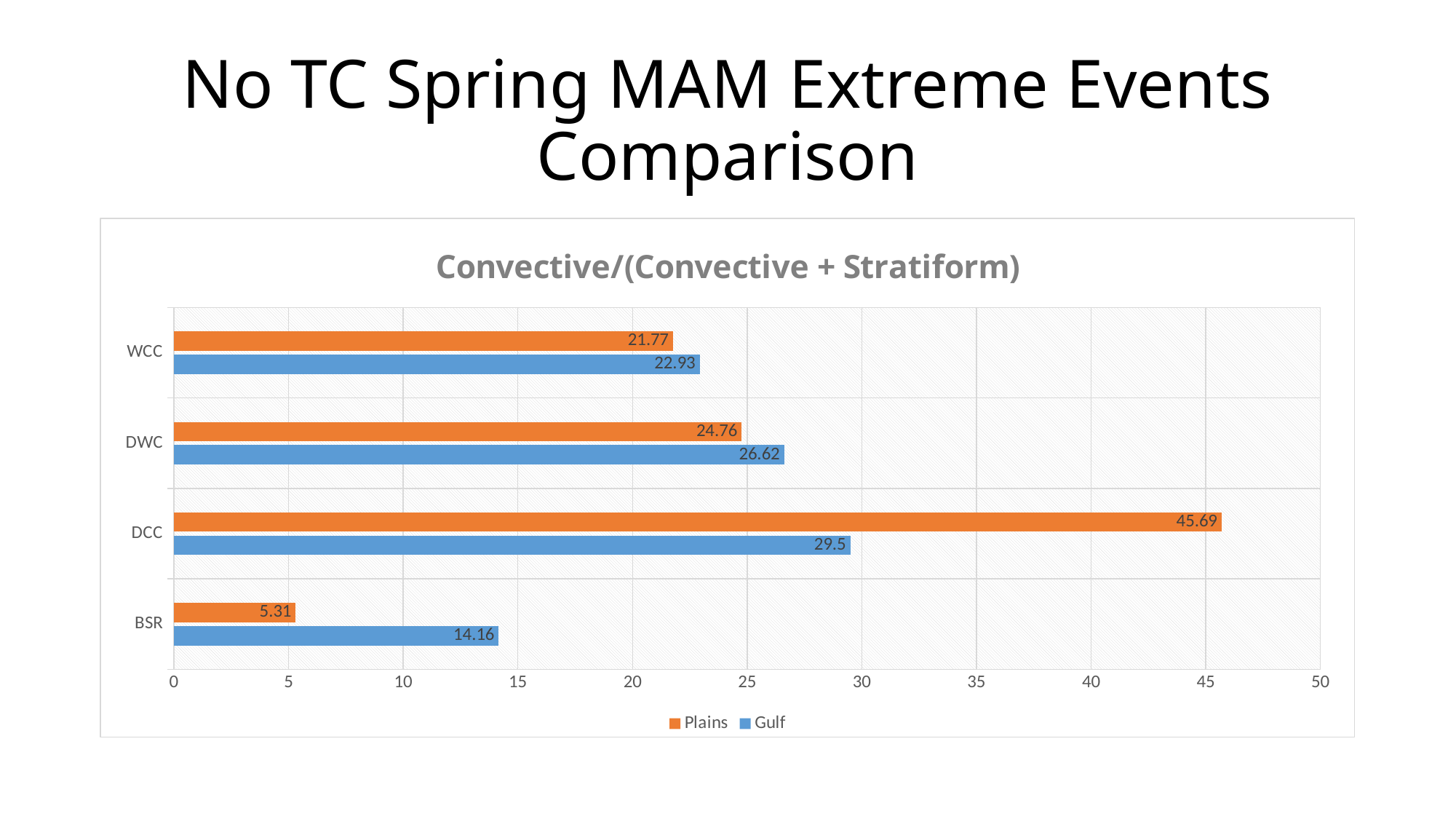
What kind of chart is shown on the slide? Bar chart What is the title of the chart? Convective/(Convective + Stratiform) Which category has the lowest Gulf value? BSR What is the Plains value for DCC? 45.69 What is the difference between the Plains and Gulf values for DCC? 16.19 What is the Plains value for WCC? 21.77 How many categories are shown on the y axis? 4 What is the Gulf value for BSR? 14.16 Which category has the highest Plains value? DCC For BSR, which series has the larger value, Plains or Gulf? Gulf What is the Gulf value for DWC? 26.62 How many series does the legend list? 2